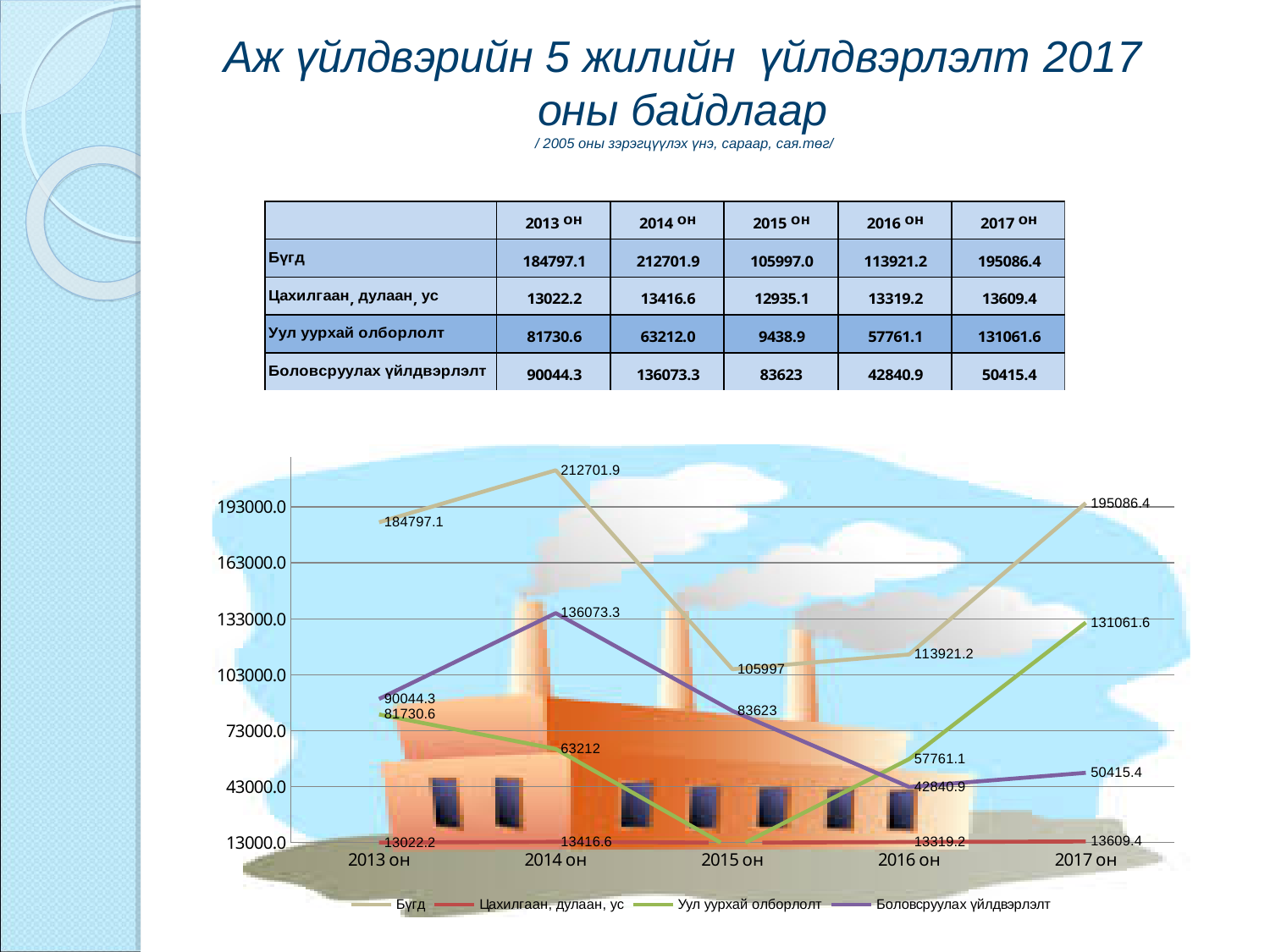
What is the value of Бүгд for 2014 он in the chart? 212701.9 Which is larger in 2014 он: Боловсруулах үйлдвэрлэлт or Уул уурхай олборлолт? Боловсруулах үйлдвэрлэлт What is the difference between Бүгд in 2017 он and Бүгд in 2016 он? 81165.2 In which year is the Бүгд series lowest in the chart? 2015 он In which year is the Бүгд series highest in the chart? 2014 он Does the Уул уурхай олборлолт series rise or fall from 2013 он to 2015 он? fall What is the value of Цахилгаан, дулаан, ус for 2013 он in the chart? 13022.2 What kind of chart is shown on the slide? line chart How many years are plotted along the x axis of the chart? 5 What is the value of Боловсруулах үйлдвэрлэлт for 2016 он in the chart? 42840.9 What is the value of Уул уурхай олборлолт for 2017 он in the chart? 131061.6 How many series does the chart legend list? 4